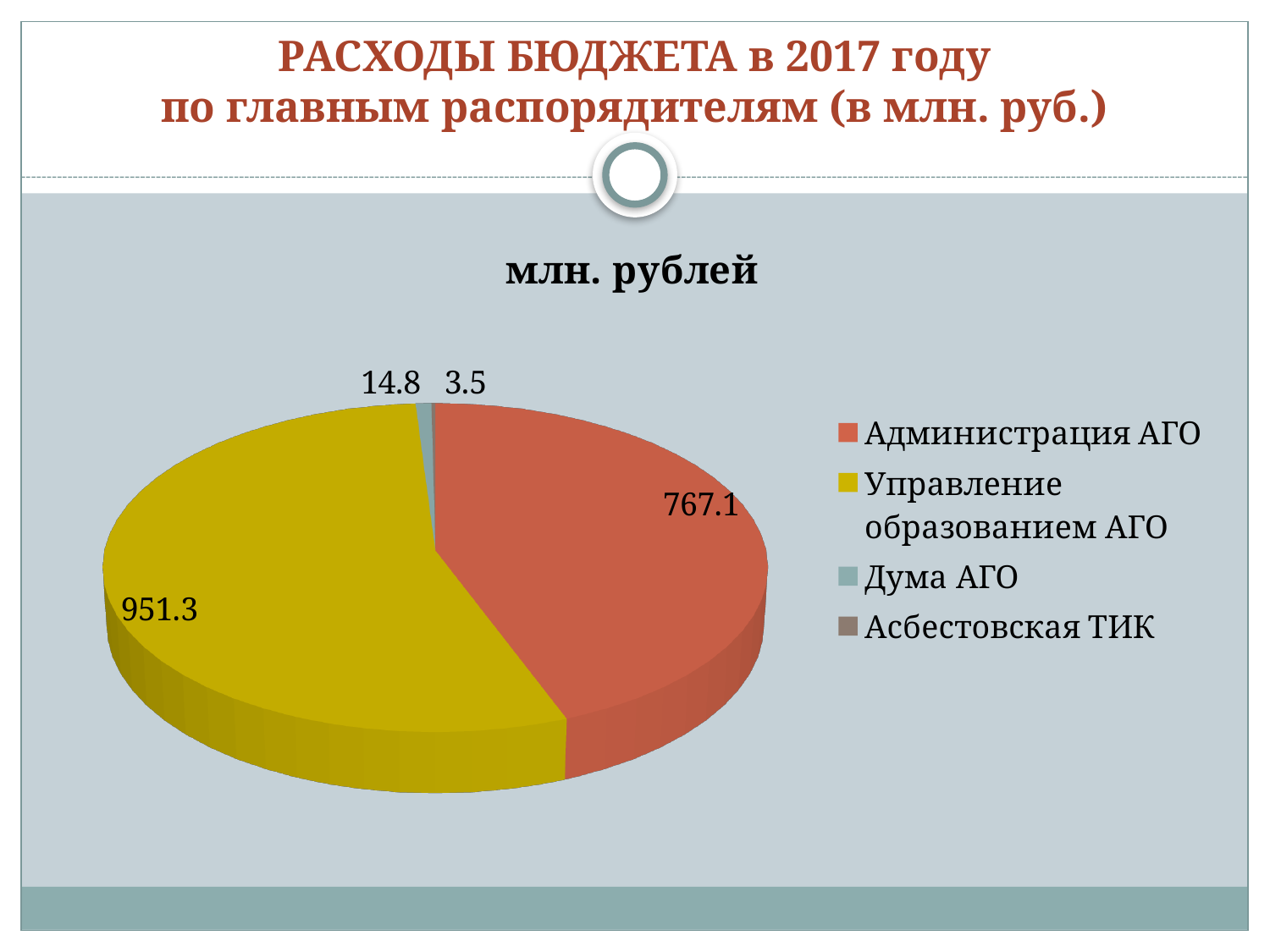
What type of chart is shown on the slide? Pie chart What is the value for Дума АГО? 14.8 Which category has the smallest slice of the pie? Асбестовская ТИК Which is larger, the value for Администрация АГО or the value for Дума АГО? Администрация АГО Which category has the largest slice of the pie? Управление образованием АГО What is the title of the chart? млн. рублей What is the value for Управление образованием АГО? 951.3 What is the value for Администрация АГО? 767.1 What is the difference between the values for Управление образованием АГО and Администрация АГО? 184.2 What is the difference between the values for Дума АГО and Асбестовская ТИК? 11.3 What is the value for Асбестовская ТИК? 3.5 How many categories does the pie chart show? 4